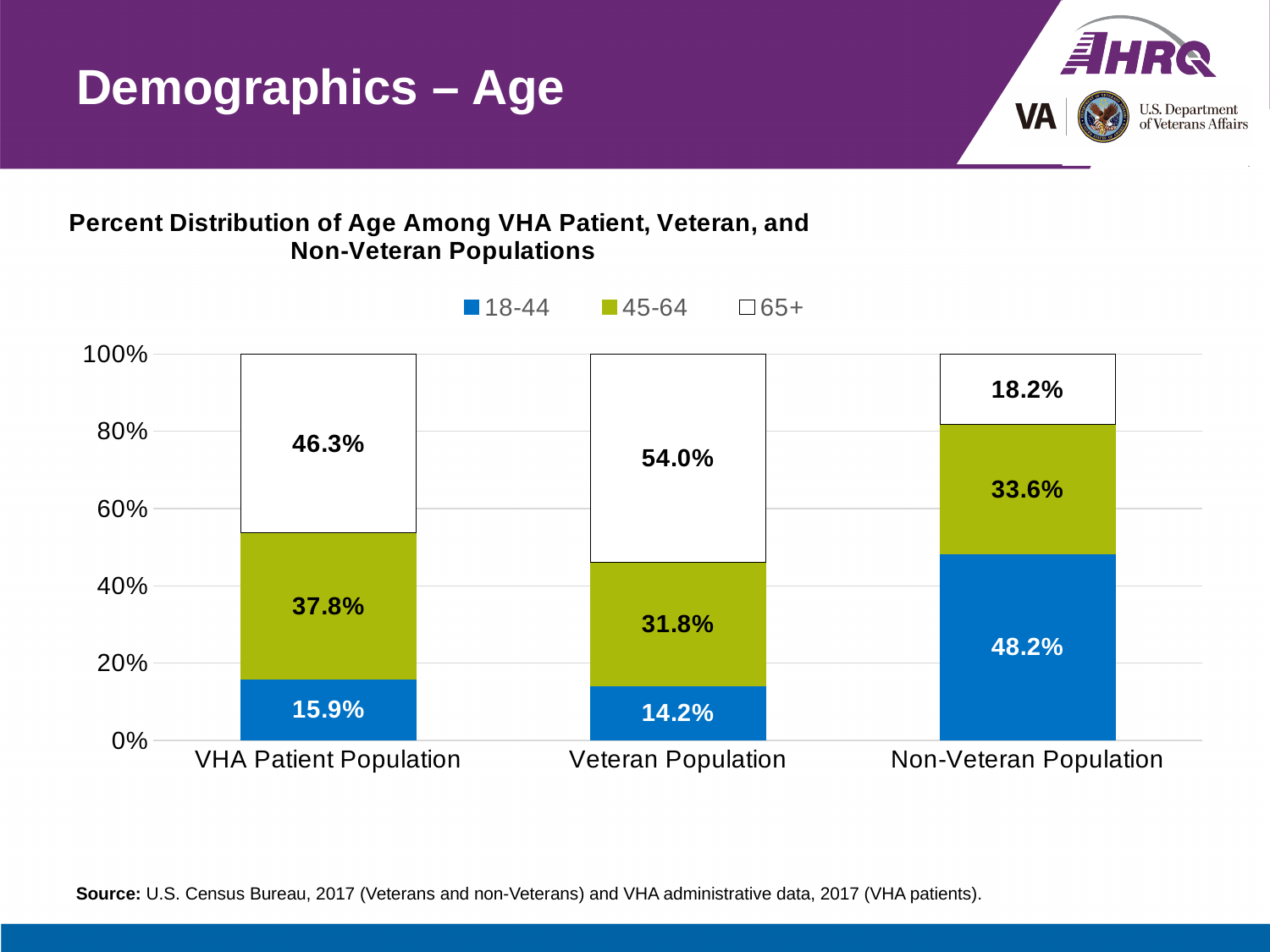
What percentage of the Non-Veteran Population is aged 18-44? 48.2% What is the total of the three segments for the Non-Veteran Population bar? 100.0% Which population has the highest share of people aged 65+? Veteran Population Which is larger: the 45-64 share of the VHA Patient Population or the 45-64 share of the Non-Veteran Population? VHA Patient Population Which population has the lowest share of people aged 18-44? Veteran Population How many populations are shown on the x axis? 3 How many age groups does the legend list? 3 What kind of chart is shown on the slide? Stacked bar chart What percentage of the VHA Patient Population is aged 65+? 46.3% Which colour represents the 18-44 age group in the legend? Blue What is the difference between the 65+ share of the Veteran Population and the 65+ share of the Non-Veteran Population? 35.8% What percentage of the Veteran Population is aged 45-64? 31.8%